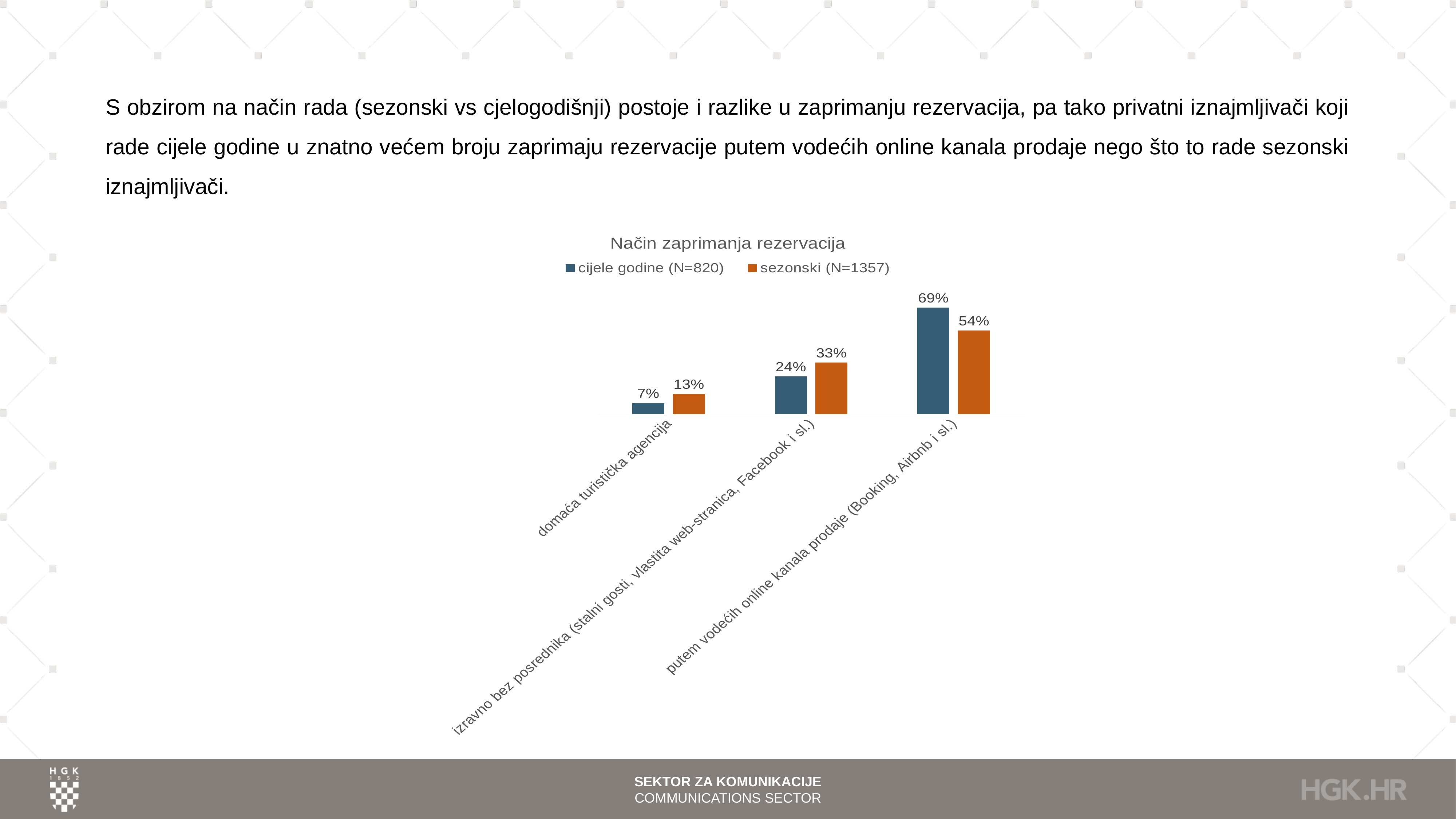
Which category has the highest value for 'cijele godine (N=820)'? putem vodećih online kanala prodaje (Booking, Airbnb i sl.) What is the value for 'sezonski (N=1357)' in the 'putem vodećih online kanala prodaje (Booking, Airbnb i sl.)' category? 54% What is the value for 'cijele godine (N=820)' in the 'domaća turistička agencija' category? 7% How many categories are shown on the x axis? 3 How many series does the legend list? 2 What is the title of the chart? Način zaprimanja rezervacija In the 'domaća turistička agencija' category, which series has the larger value? sezonski (N=1357) What kind of chart is shown on the slide? bar chart What is the value for 'sezonski (N=1357)' in the 'izravno bez posrednika (stalni gosti, vlastita web-stranica, Facebook i sl.)' category? 33% What is the difference between 'cijele godine (N=820)' and 'sezonski (N=1357)' in the 'putem vodećih online kanala prodaje (Booking, Airbnb i sl.)' category? 15% Which category has the lowest value for 'sezonski (N=1357)'? domaća turistička agencija What is the difference between 'sezonski (N=1357)' and 'cijele godine (N=820)' in the 'izravno bez posrednika (stalni gosti, vlastita web-stranica, Facebook i sl.)' category? 9%